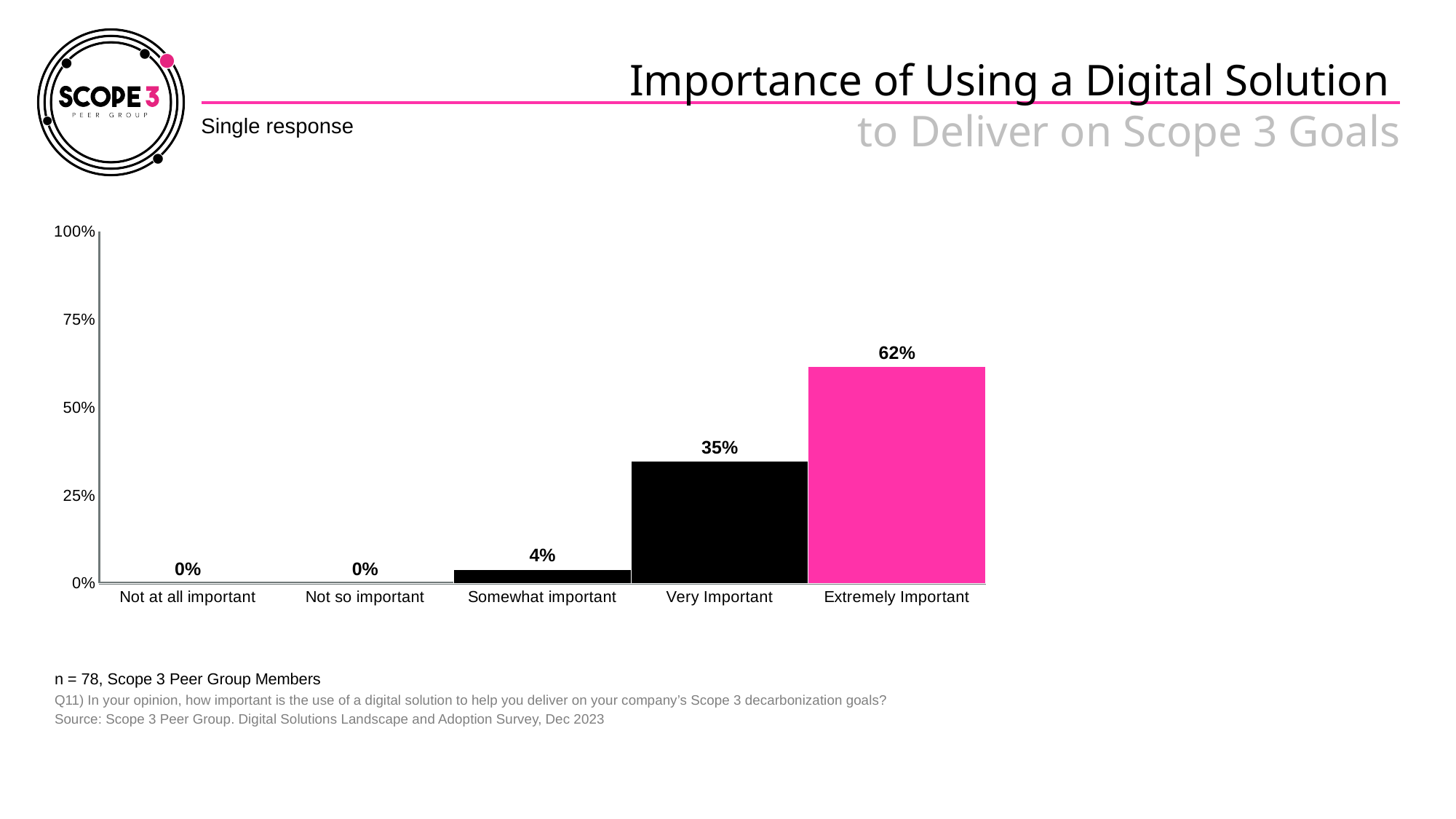
How many response categories are shown on the x axis? 5 Do the values rise or fall moving from left to right along the x axis? Rise Is the value for Extremely Important greater or less than 50%? greater Which response category has the highest percentage? Extremely Important What percentage of respondents rated using a digital solution as Extremely Important? 62% What percentage of respondents chose Not at all important? 0% What is the difference in percentage points between Extremely Important and Very Important? 27 What kind of chart is shown on the slide? Bar chart What percentage of respondents chose Very Important? 35% Which is larger, the value for Very Important or the value for Somewhat important? Very Important What percentage of respondents chose Somewhat important? 4% Which bar is coloured pink rather than black? Extremely Important